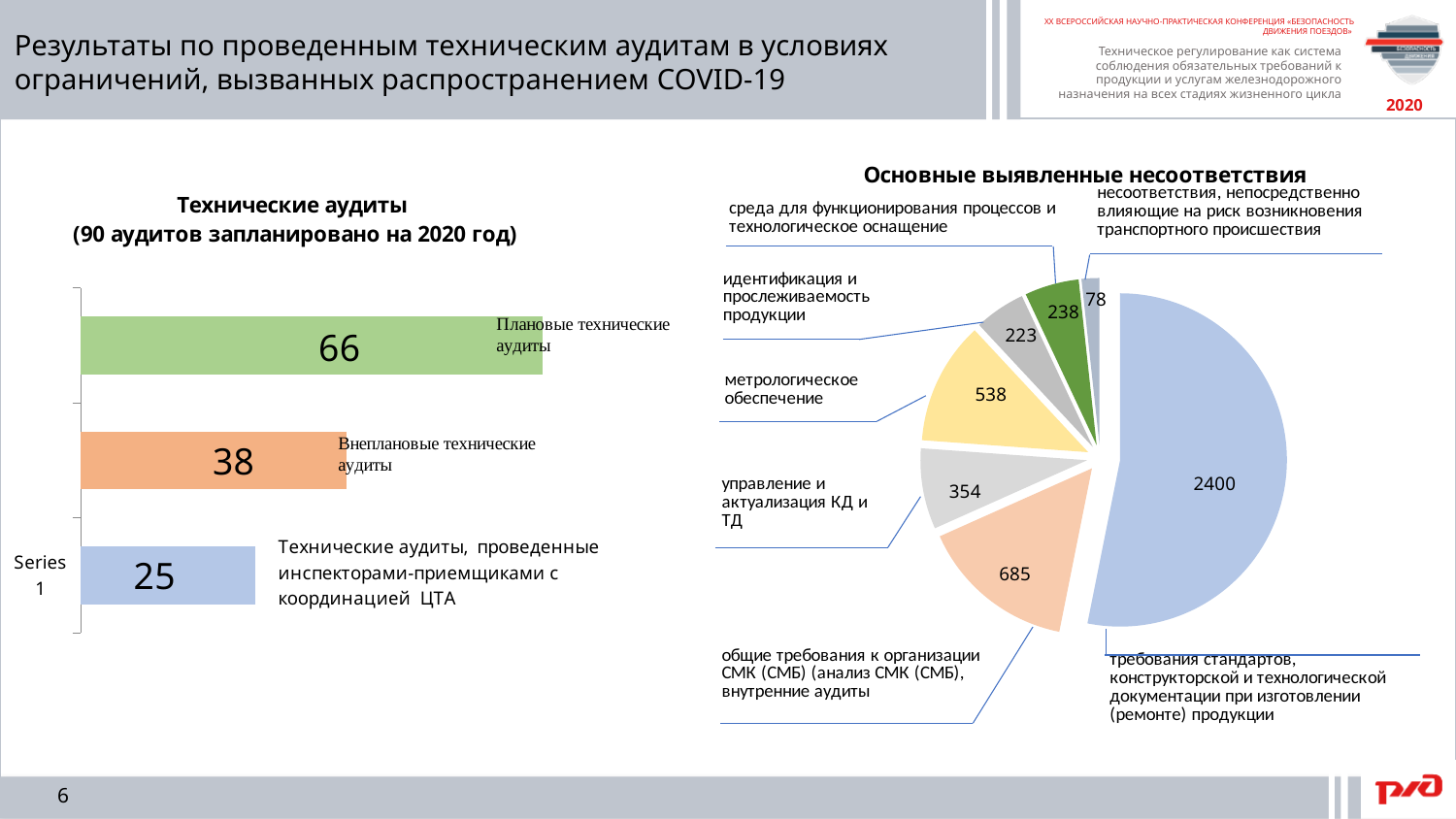
In the pie chart 'Основные выявленные несоответствия', what is the value for 'метрологическое обеспечение'? 538 In the bar chart 'Технические аудиты', what is the difference between 'Плановые технические аудиты' and 'Внеплановые технические аудиты'? 28 What type of chart is the chart on the left of the slide? bar chart In the bar chart 'Технические аудиты', how many bars are plotted? 3 In the bar chart 'Технические аудиты', which category has the lowest value? Технические аудиты, проведенные инспекторами-приемщиками с координацией ЦТА In the pie chart 'Основные выявленные несоответствия', what is the difference between the slice valued 685 and the slice valued 354? 331 In the pie chart 'Основные выявленные несоответствия', which is larger: 'идентификация и прослеживаемость продукции' or 'среда для функционирования процессов и технологическое оснащение'? среда для функционирования процессов и технологическое оснащение In the bar chart 'Технические аудиты', what is the value for 'Внеплановые технические аудиты'? 38 In the pie chart 'Основные выявленные несоответствия', which category has the largest slice? требования стандартов, конструкторской и технологической документации при изготовлении (ремонте) продукции In the bar chart 'Технические аудиты', what is the value for 'Плановые технические аудиты'? 66 In the pie chart 'Основные выявленные несоответствия', how many slices are there? 7 In the pie chart 'Основные выявленные несоответствия', what is the value for 'управление и актуализация КД и ТД'? 354